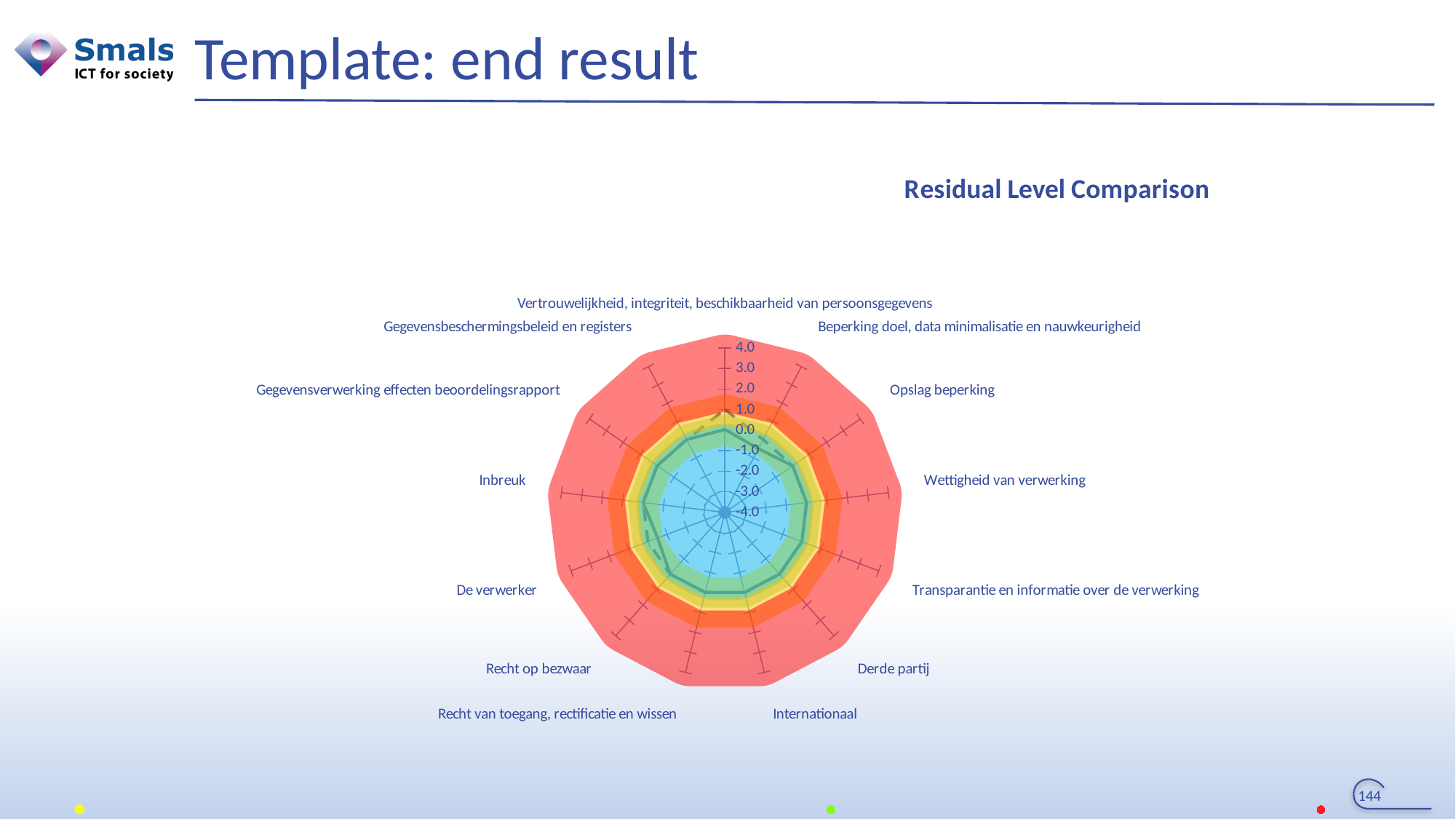
Is the dashed-line value for Wettigheid van verwerking greater or less than 2.0? less Is the solid-line value for Derde partij greater or less than 2.0? less What kind of chart is shown on the slide? radar chart Is the dashed-line value for Vertrouwelijkheid, integriteit, beschikbaarheid van persoonsgegevens greater or less than 3.0? less What is the highest value shown on the chart's axis scale? 4.0 How many categories (axes) does the radar chart have? 13 What is the title of the chart? Residual Level Comparison